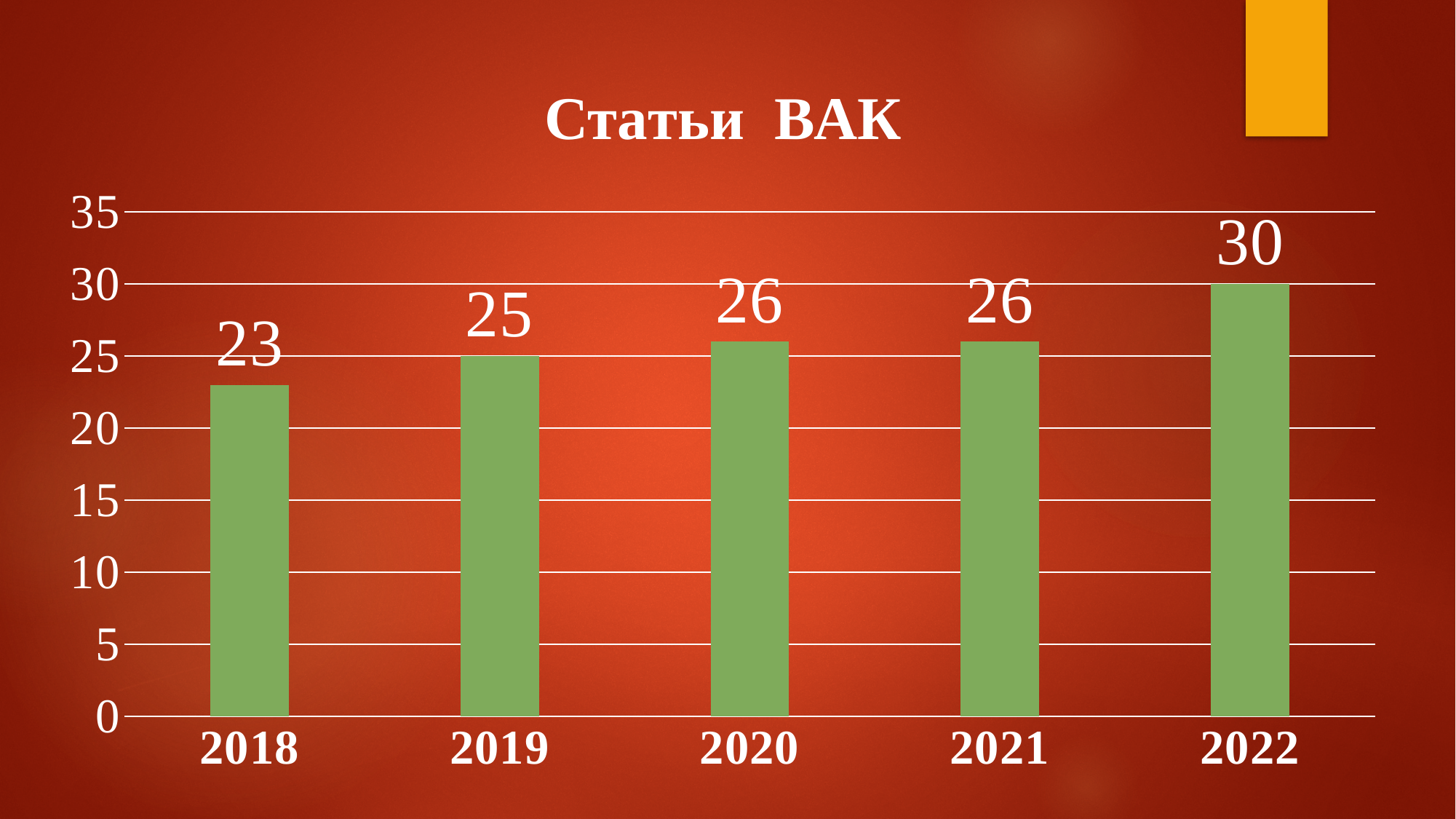
What is the title of the chart? Статьи ВАК Is the value for 2018 greater or less than 25? less How many years are shown on the x axis? 5 Which is larger, the value for 2019 or the value for 2022? 2022 What is the value for 2020? 26 Which year has the highest value? 2022 What kind of chart is shown? bar chart What is the value for 2022? 30 Which year has the lowest value? 2018 What is the difference between the values for 2022 and 2018? 7 What is the difference between the values for 2019 and 2018? 2 What is the value for 2018? 23